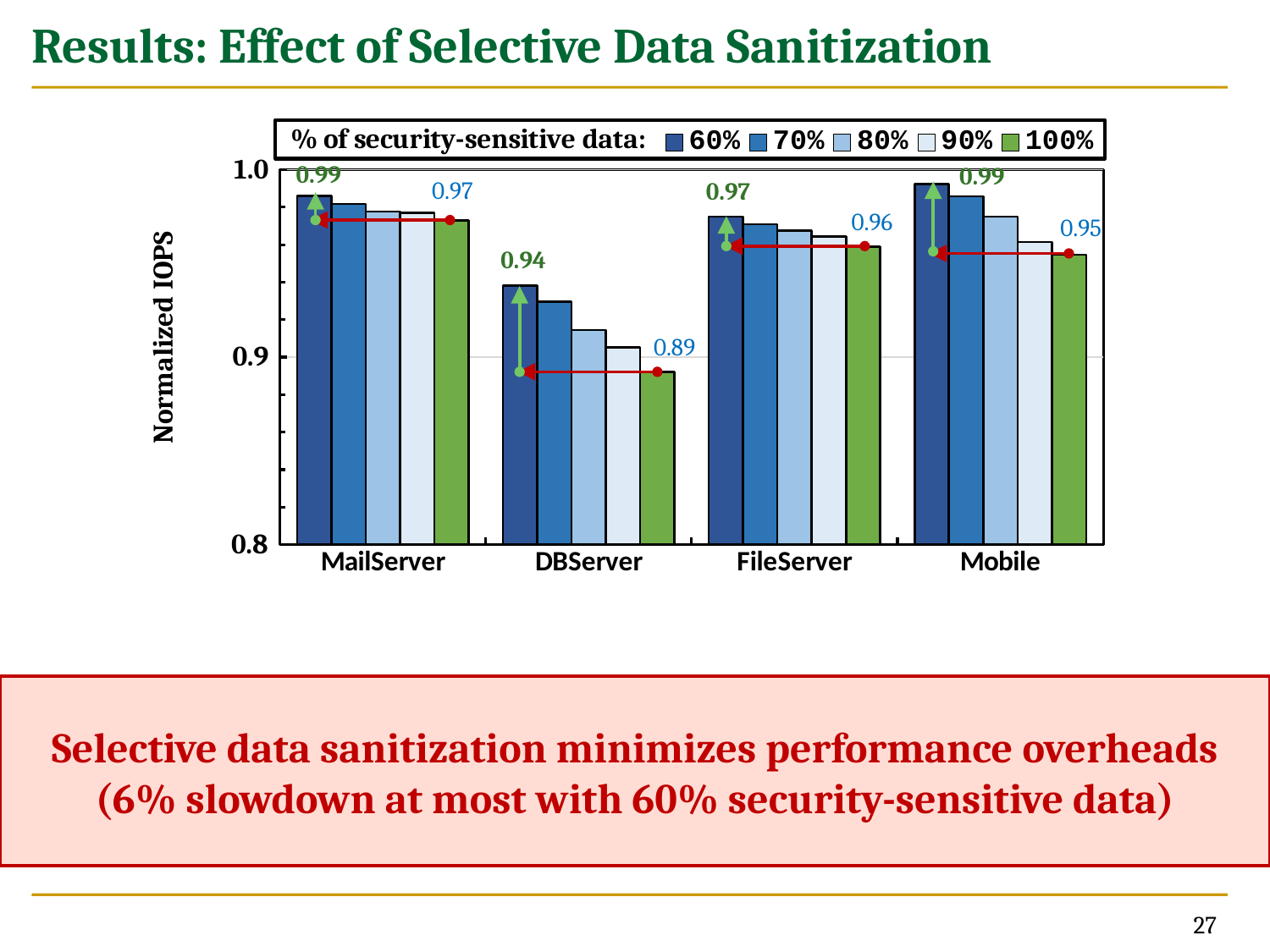
What is the difference in normalized IOPS for DBServer between 60% and 100% security-sensitive data? 0.05 Which workload has the lowest normalized IOPS with 100% security-sensitive data? DBServer How many workloads are shown on the x axis? 4 What kind of chart is shown on the slide? bar chart What is the normalized IOPS for Mobile with 100% security-sensitive data? 0.95 What is the normalized IOPS for DBServer with 60% security-sensitive data? 0.94 What is the normalized IOPS for DBServer with 100% security-sensitive data? 0.89 What is the normalized IOPS for MailServer with 60% security-sensitive data? 0.99 Is the normalized IOPS for DBServer with 80% security-sensitive data greater or less than 0.9? greater Which workload has the lowest normalized IOPS with 60% security-sensitive data? DBServer With 100% security-sensitive data, which has higher normalized IOPS: FileServer or Mobile? FileServer How many series does the legend list? 5